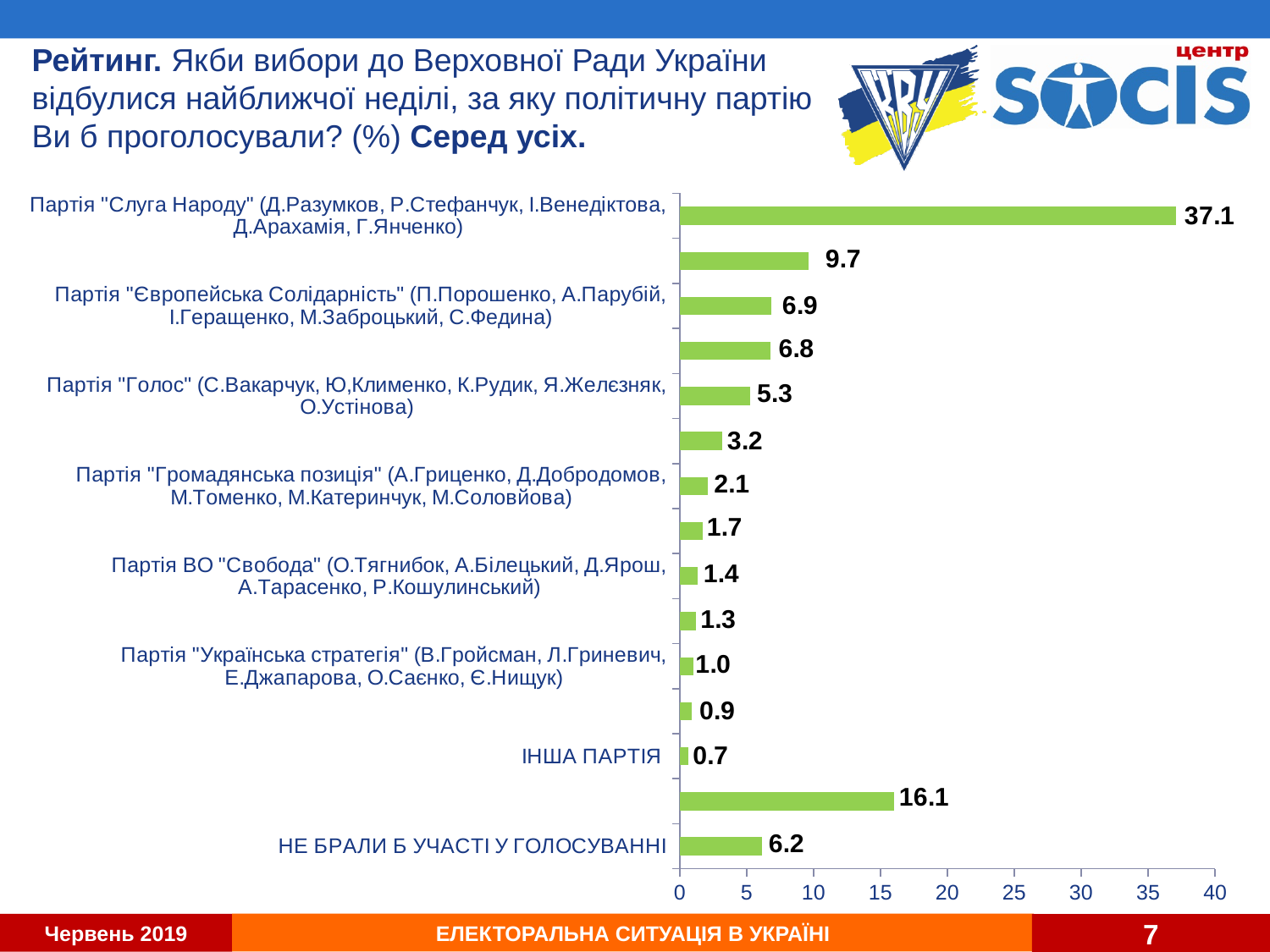
What is the value for Партія "Європейська Солідарність"? 6.9 What is the value for ІНША ПАРТІЯ? 0.7 What is the difference between the values for Партія "Слуга Народу" and Партія "Європейська Солідарність"? 30.2 Is the value for Партія "Слуга Народу" greater or less than 35? greater What is the value for Партія "Слуга Народу"? 37.1 What kind of chart is shown on the slide? bar chart What is the value for НЕ БРАЛИ Б УЧАСТІ У ГОЛОСУВАННІ? 6.2 What is the value for Партія ВО "Свобода"? 1.4 What is the value for Партія "Голос"? 5.3 How many bars are plotted in the chart? 15 Which is larger, the value for Партія "Голос" or the value for Партія "Громадянська позиція"? Партія "Голос" Which category has the highest value in the chart? Партія "Слуга Народу"